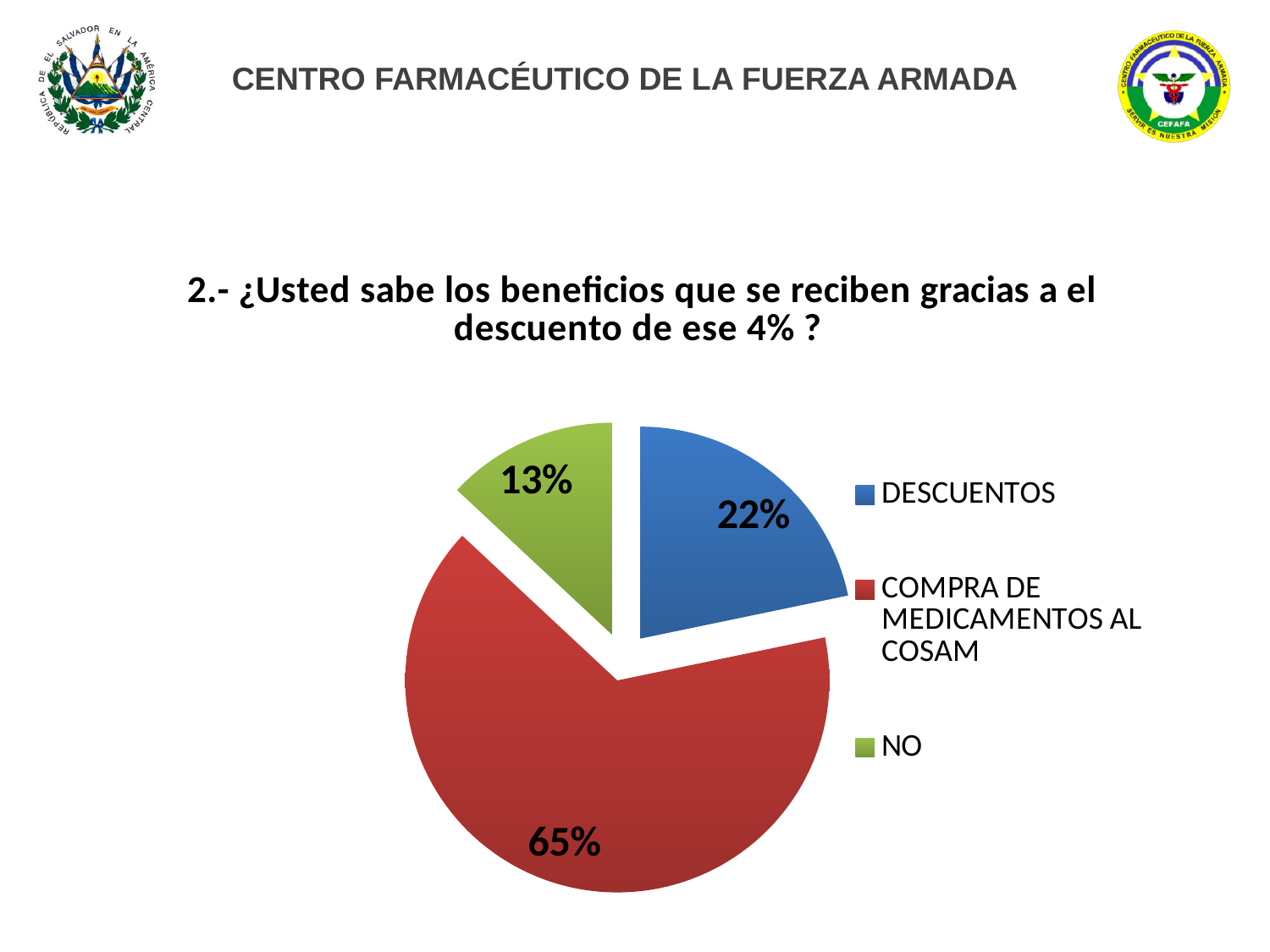
What is the difference in percentage points between COMPRA DE MEDICAMENTOS AL COSAM and DESCUENTOS? 43 How many entries does the legend list? 3 How many slices does the pie chart have? 3 What is the difference in percentage points between DESCUENTOS and NO? 9 What percentage of the pie does COMPRA DE MEDICAMENTOS AL COSAM represent? 65% What kind of chart is shown on the slide? pie chart Which category has the largest share of the pie? COMPRA DE MEDICAMENTOS AL COSAM Which is larger, the share for DESCUENTOS or the share for NO? DESCUENTOS What percentage of the pie does NO represent? 13% Which category has the smallest share of the pie? NO What percentage of the pie does DESCUENTOS represent? 22% What colour is the slice for NO? green